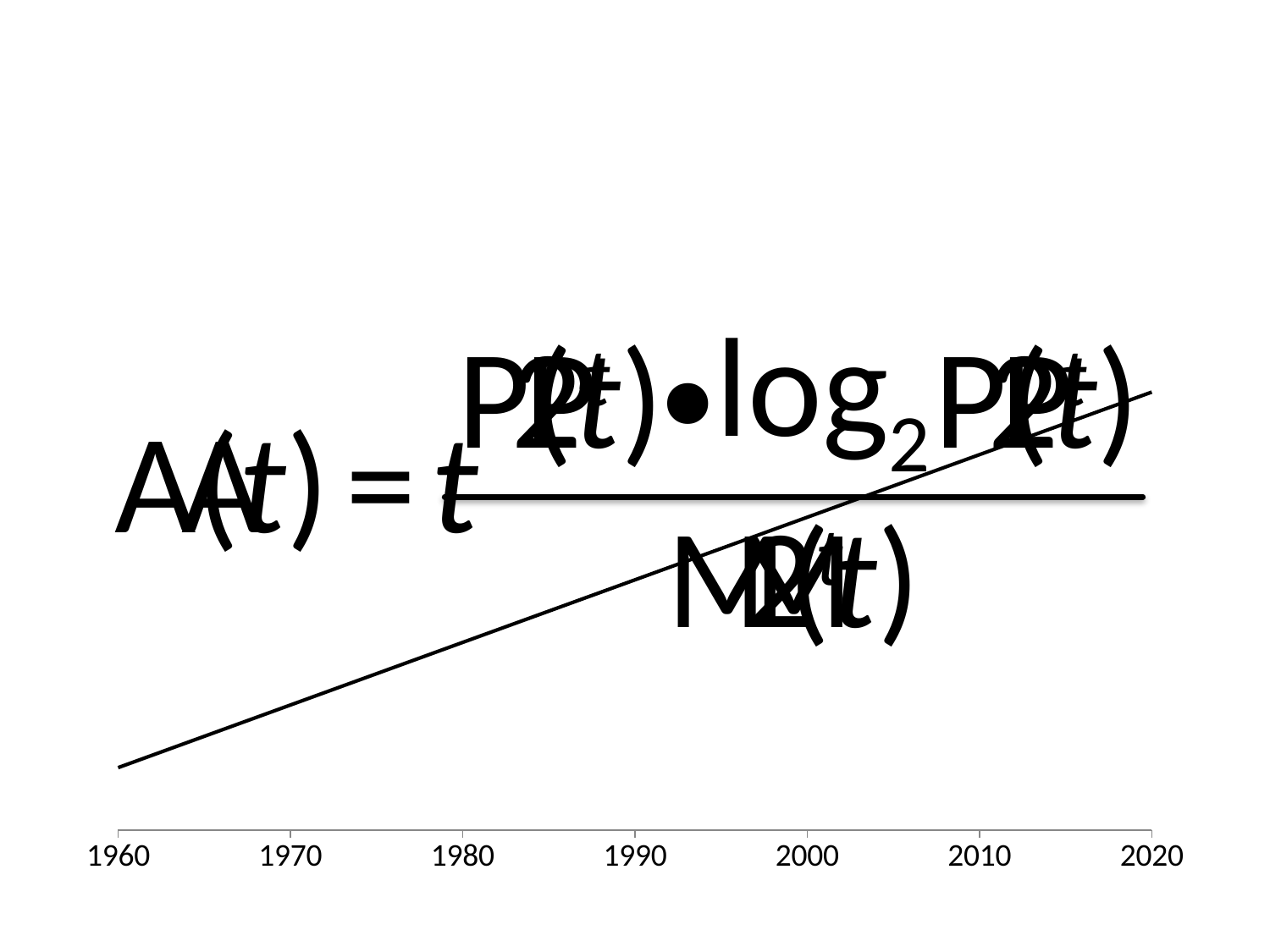
Is the plotted value larger at 1980 or at 2000? 2000 What kind of chart is shown on the slide? line chart Is the plotted value larger at 1960 or at 2020? 2020 At which year on the x axis is the plotted line at its lowest point? 1960 Do the values of the plotted line rise or fall from 1960 to 2020? rise At which year on the x axis does the plotted line reach its highest point? 2020 What is the last year label on the x axis? 2020 How many year labels are shown on the x axis? 7 What is the first year label on the x axis? 1960